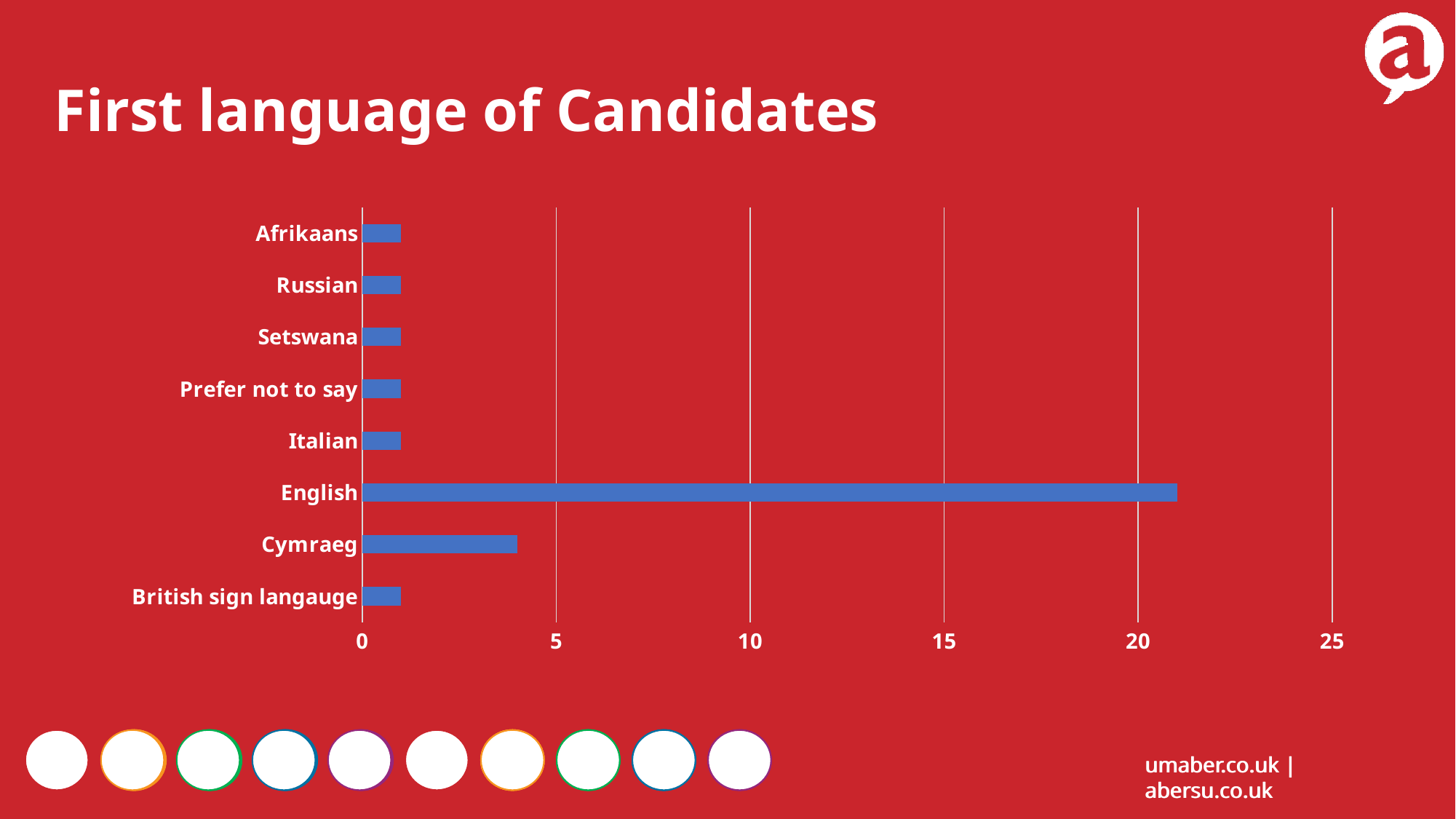
What is the title of the chart? First language of Candidates How many language categories are shown on the chart? 8 What is the highest value shown on the horizontal axis? 25 Which category has the second-highest value? Cymraeg Is the value for Cymraeg greater or less than 5? less Is the value for Afrikaans greater or less than 5? less Is the value for English greater or less than 20? greater Which category has the highest value? English What kind of chart is shown on the slide? bar chart Which is larger, the value for Cymraeg or the value for Russian? Cymraeg Which is larger, the value for English or the value for Cymraeg? English